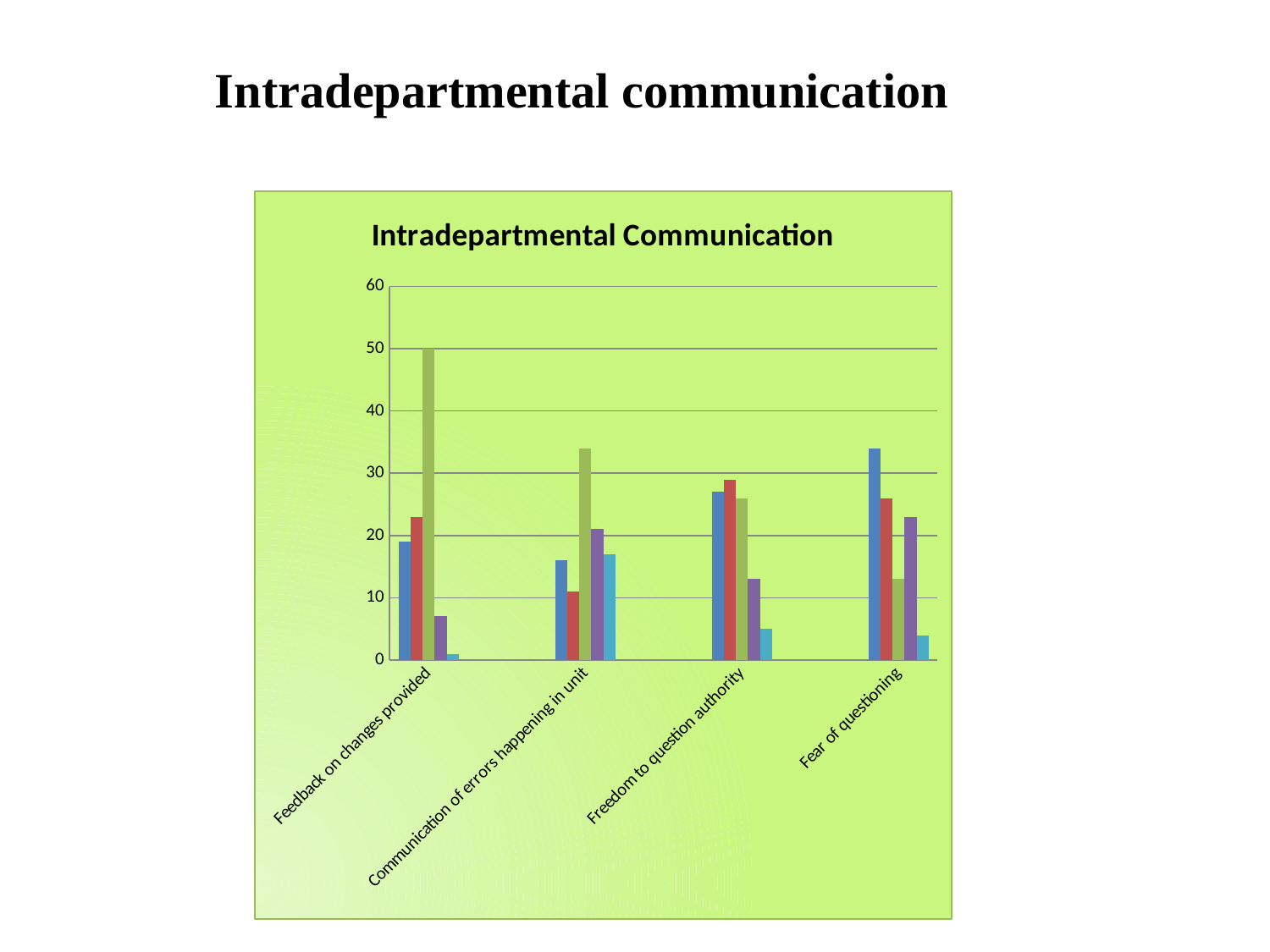
Is the value of the red bar for Communication of errors happening in unit greater or less than 20? less Which coloured bar is the lowest for Feedback on changes provided? the light blue bar What is the title shown inside the chart area? Intradepartmental Communication Is the value of the blue bar for Fear of questioning greater or less than 30? greater Is the value of the light blue bar for Freedom to question authority greater or less than 10? less For Fear of questioning, which is larger: the blue bar or the red bar? the blue bar Which category contains the tallest bar in the chart? Feedback on changes provided How many bars are plotted for each category in the chart? 5 What kind of chart is shown on the slide? bar chart How many categories are shown on the x axis of the chart? 4 For Feedback on changes provided, which is larger: the red bar or the purple bar? the red bar